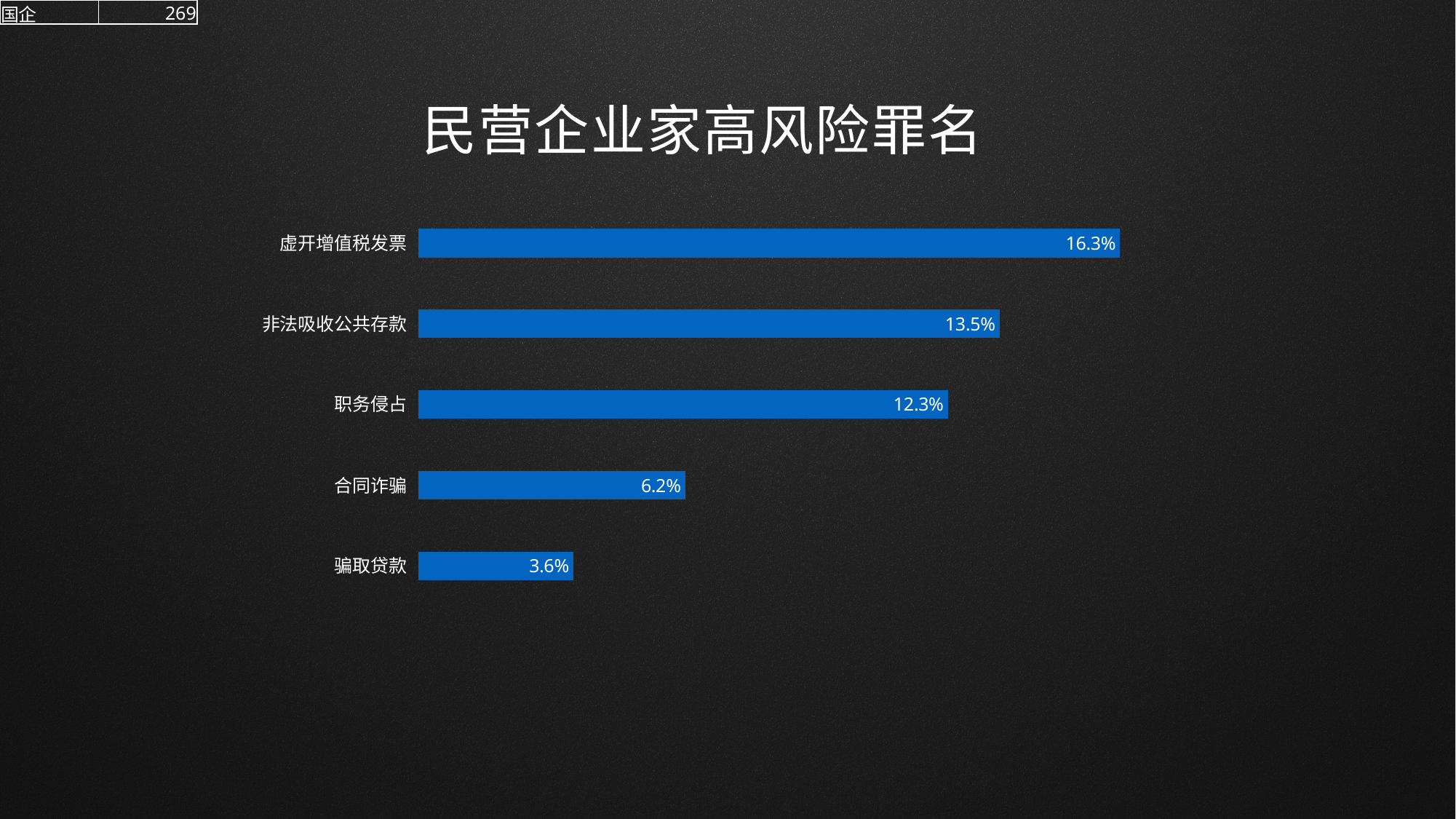
What is the value for 非法吸收公共存款? 13.5% What is the value for 合同诈骗? 6.2% What kind of chart is shown on the slide? Bar chart How many categories are shown in the chart? 5 What is the difference between the values for 虚开增值税发票 and 非法吸收公共存款? 2.8% Which category has the highest value? 虚开增值税发票 What is the value for 虚开增值税发票? 16.3% What is the title of the chart? 民营企业家高风险罪名 Which category has the lowest value? 骗取贷款 Which is larger, the value for 合同诈骗 or the value for 骗取贷款? 合同诈骗 What is the value for 职务侵占? 12.3% What is the value for 骗取贷款? 3.6%